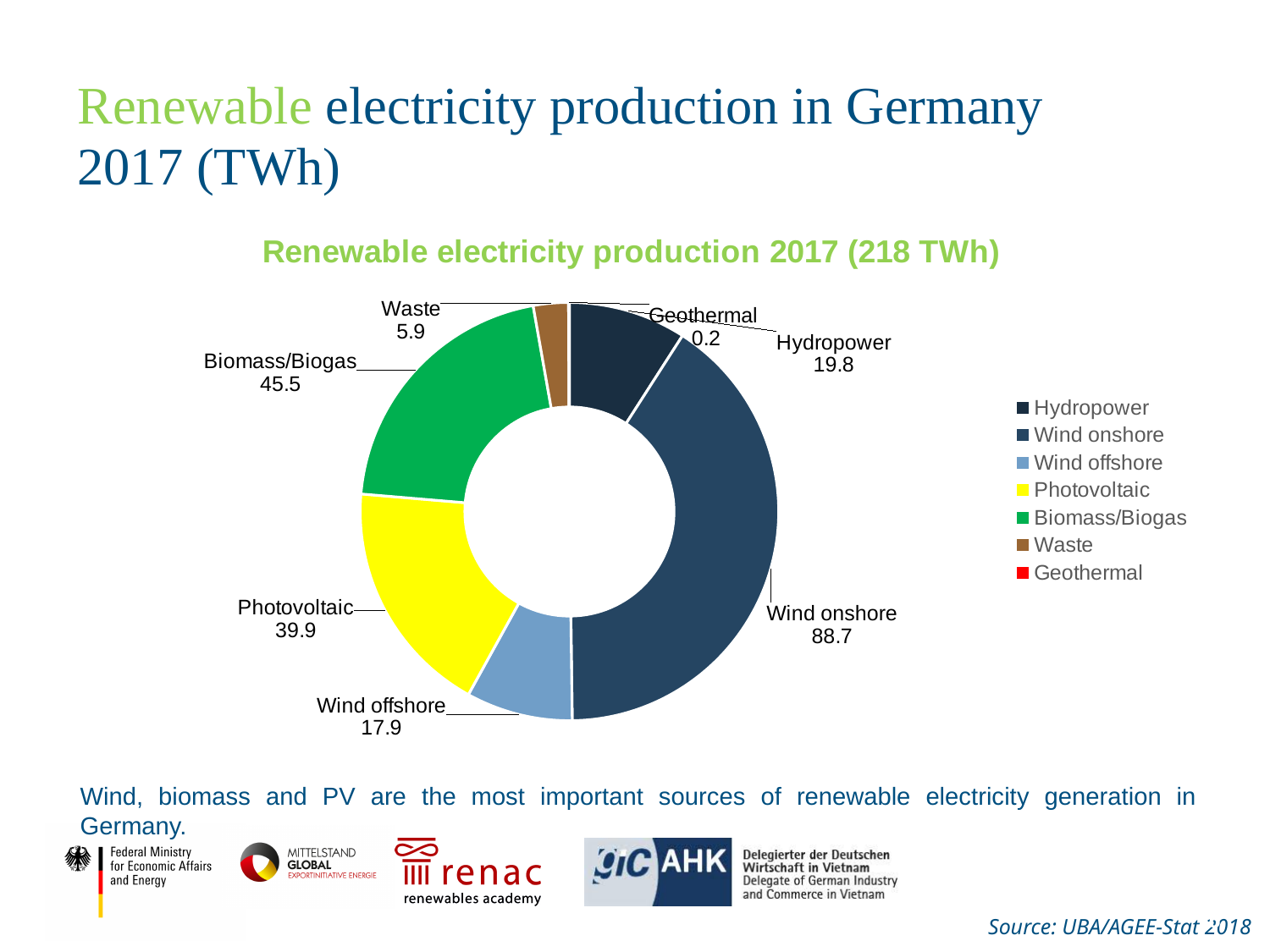
What is the value for Wind onshore in the chart? 88.7 Which source has the smallest value in the chart? Geothermal Which is larger, the value for Hydropower or the value for Wind offshore? Hydropower Which source has the largest share of renewable electricity production in the chart? Wind onshore What total renewable electricity production is stated in the chart title? 218 TWh What is the difference between the values for Hydropower and Wind offshore? 1.9 What kind of chart is shown on the slide? doughnut chart What is the value for Geothermal in the chart? 0.2 What is the value for Waste in the chart? 5.9 What is the value for Biomass/Biogas in the chart? 45.5 How many sources (slices) are shown in the chart? 7 What is the difference between the values for Biomass/Biogas and Photovoltaic? 5.6